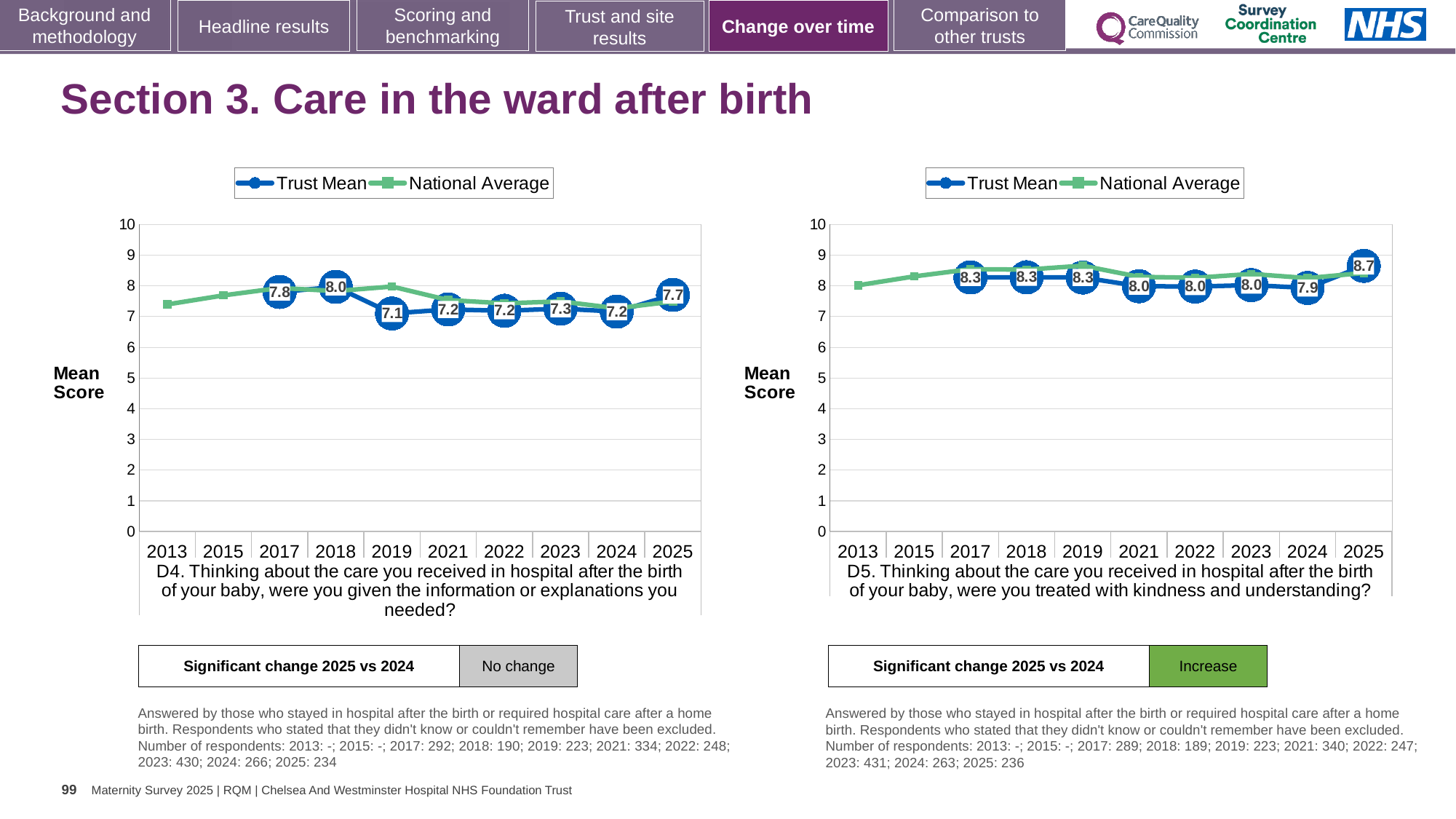
On the D4 chart (left), is the National Average value for 2013 greater or less than 8? less How many series does the legend of the D4 chart (left) list? 2 On the D4 chart (left), what is the Trust Mean score for 2025? 7.7 How many years are shown on the x axis of the D5 chart (right)? 10 On the D5 chart (right), what is the difference between the Trust Mean scores for 2025 and 2024? 0.8 On the D5 chart (right), which year has the highest Trust Mean score? 2025 What kind of chart is the D5 chart (right)? Line chart On the D4 chart (left), which year has the lowest Trust Mean score? 2019 On the D4 chart (left), which year has the highest Trust Mean score? 2018 On the D5 chart (right), what is the significant change result for 2025 vs 2024? Increase On the D5 chart (right), what is the Trust Mean score for 2024? 7.9 On the D4 chart (left), is the Trust Mean score higher in 2017 or in 2019? 2017